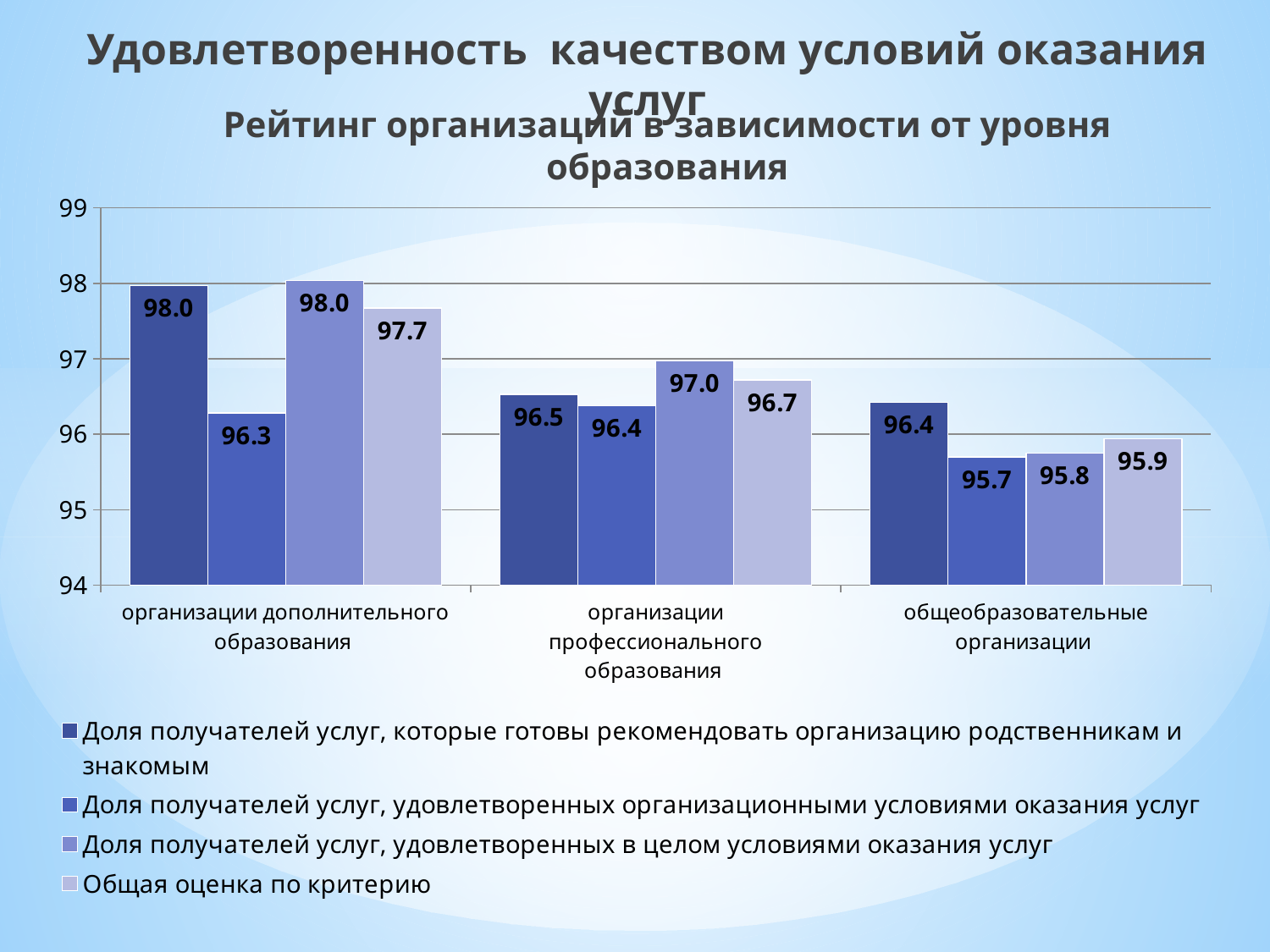
What is the title of the chart? Рейтинг организаций в зависимости от уровня образования Is the value of "Доля получателей услуг, удовлетворенных организационными условиями оказания услуг" for организации дополнительного образования greater or less than 97? less Which is larger for организации профессионального образования: "Доля получателей услуг, которые готовы рекомендовать организацию родственникам и знакомым" or "Доля получателей услуг, удовлетворенных в целом условиями оказания услуг"? Доля получателей услуг, удовлетворенных в целом условиями оказания услуг What kind of chart is shown on the slide? bar chart What is the value of "Доля получателей услуг, удовлетворенных в целом условиями оказания услуг" for организации профессионального образования? 97.0 How many categories are shown on the x axis of the chart? 3 What is the value of "Доля получателей услуг, удовлетворенных организационными условиями оказания услуг" for общеобразовательные организации? 95.7 Which category has the highest value for "Общая оценка по критерию"? организации дополнительного образования How many series does the legend list? 4 What is the value of "Общая оценка по критерию" for организации дополнительного образования? 97.7 What is the difference between "Общая оценка по критерию" for организации дополнительного образования and for общеобразовательные организации? 1.8 Which category has the lowest value for "Доля получателей услуг, удовлетворенных организационными условиями оказания услуг"? общеобразовательные организации